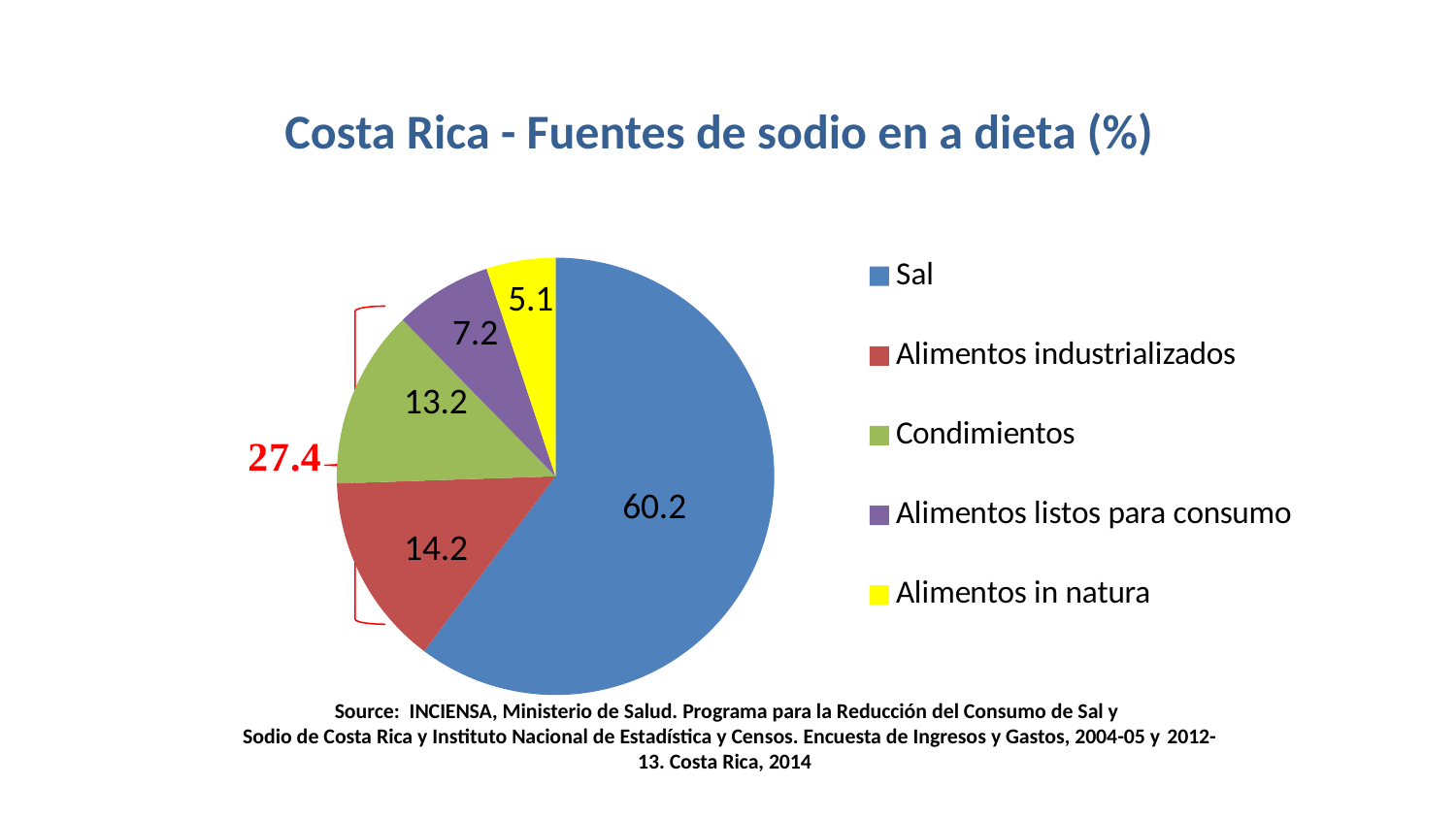
What is the value for Sal? 60.2 Which category has the largest slice of the pie? Sal How many categories does the legend list? 5 What is the value for Condimientos? 13.2 Which is larger, the value for Alimentos listos para consumo or the value for Alimentos in natura? Alimentos listos para consumo What is the difference between the values for Sal and Alimentos industrializados? 46 What value does the red bracket annotation next to the pie show? 27.4 Which category has the smallest slice of the pie? Alimentos in natura What kind of chart is shown on the slide? pie chart What is the value for Alimentos industrializados? 14.2 What is the value for Alimentos in natura? 5.1 What is the value for Alimentos listos para consumo? 7.2